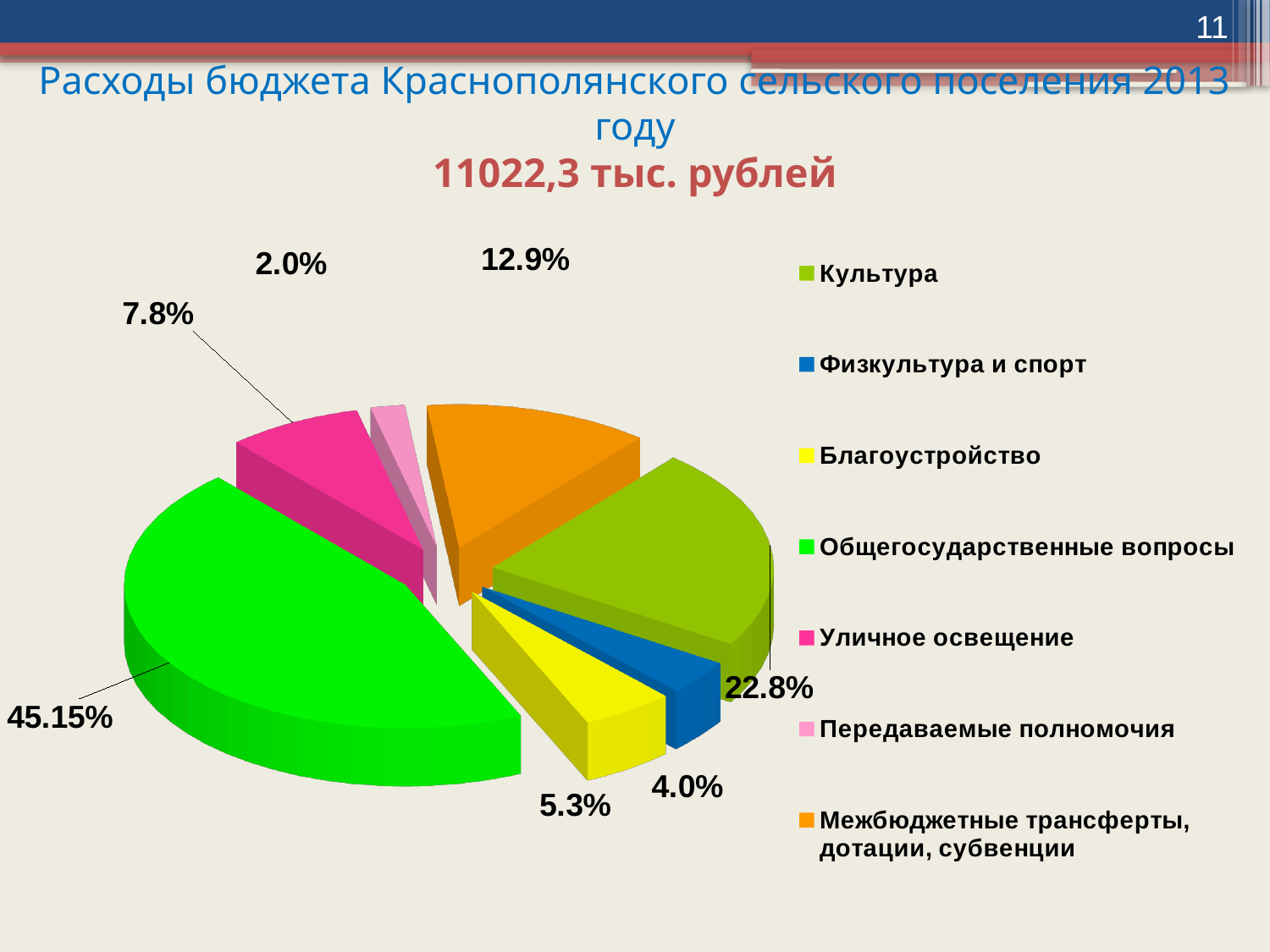
Which category has the smallest share of the pie? Передаваемые полномочия What share of the budget expenses goes to Благоустройство? 5.3% What is the difference in percentage points between the shares for Культура and Межбюджетные трансферты, дотации, субвенции? 9.9 What share of the budget expenses goes to Культура? 22.8% Which is larger, the share for Благоустройство or the share for Физкультура и спорт? Благоустройство What kind of chart is shown on the slide? pie chart What share of the budget expenses goes to Межбюджетные трансферты, дотации, субвенции? 12.9% Which category has the largest share of the pie? Общегосударственные вопросы What share of the budget expenses goes to Физкультура и спорт? 4.0% What share of the budget expenses goes to Уличное освещение? 7.8% How many categories does the legend list? 7 What share of the budget expenses goes to Общегосударственные вопросы? 45.15%